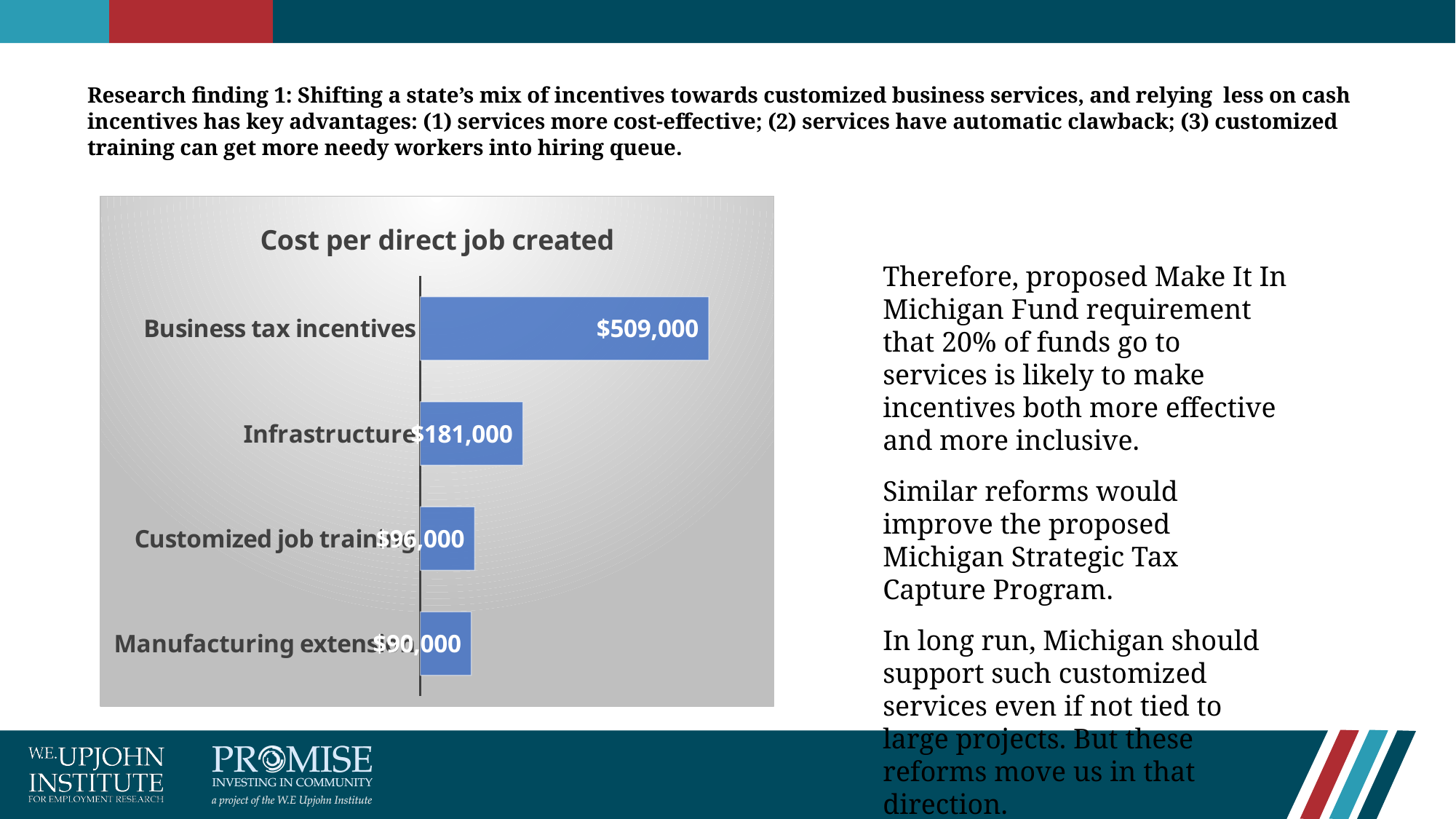
What is the cost per direct job created for Infrastructure? $181,000 Which category has the lowest cost per direct job created? Manufacturing extension Which has a higher cost per direct job created, Infrastructure or Customized job training? Infrastructure What is the title of the chart? Cost per direct job created How many categories are shown in the chart? 4 Which category has the highest cost per direct job created? Business tax incentives What is the difference in cost per direct job created between Customized job training and Manufacturing extension? $6,000 What is the cost per direct job created for Business tax incentives? $509,000 What is the cost per direct job created for Manufacturing extension? $90,000 What is the cost per direct job created for Customized job training? $96,000 What type of chart is shown on the slide? Bar chart What is the difference in cost per direct job created between Business tax incentives and Infrastructure? $328,000